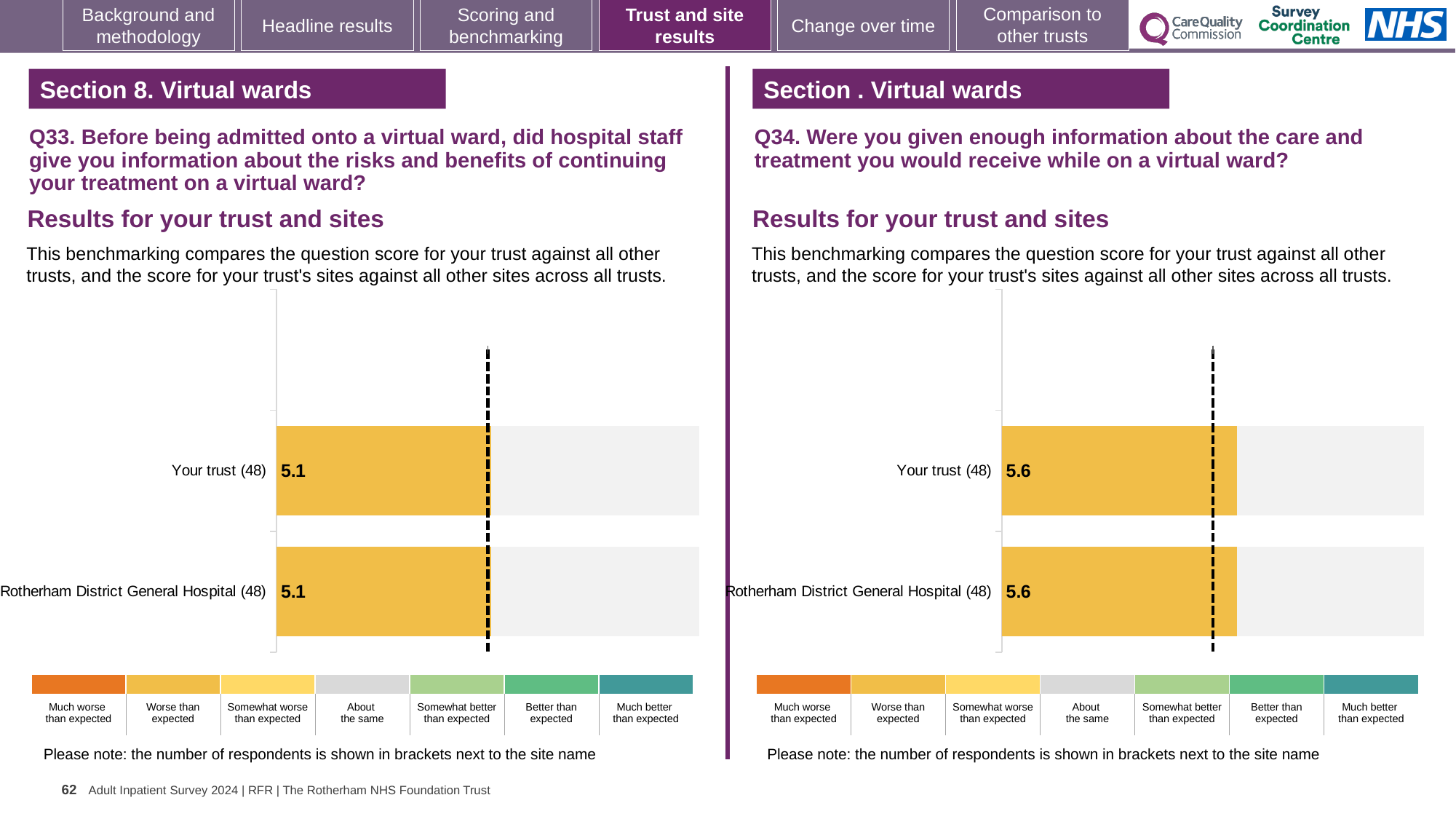
What is the difference between the Your trust score in the Q34 chart on the right and the Your trust score in the Q33 chart on the left? 0.5 How many categories does the colour key below the Q34 chart on the right list? 7 In the Q34 chart on the right, what is the score for Rotherham District General Hospital (48)? 5.6 In the Q34 chart on the right, what is the score for Your trust (48)? 5.6 Is the Your trust score in the Q34 chart on the right larger or smaller than the Your trust score in the Q33 chart on the left? Larger What kind of chart is used in the Q33 chart on the left? Bar chart In the Q33 chart on the left, what is the score for Rotherham District General Hospital (48)? 5.1 In the Q33 chart on the left, what is the score for Your trust (48)? 5.1 How many bars are plotted in the Q33 chart on the left? 2 In the Q33 chart on the left, how many respondents are shown in brackets next to Your trust? 48 How many bars are plotted in the Q34 chart on the right? 2